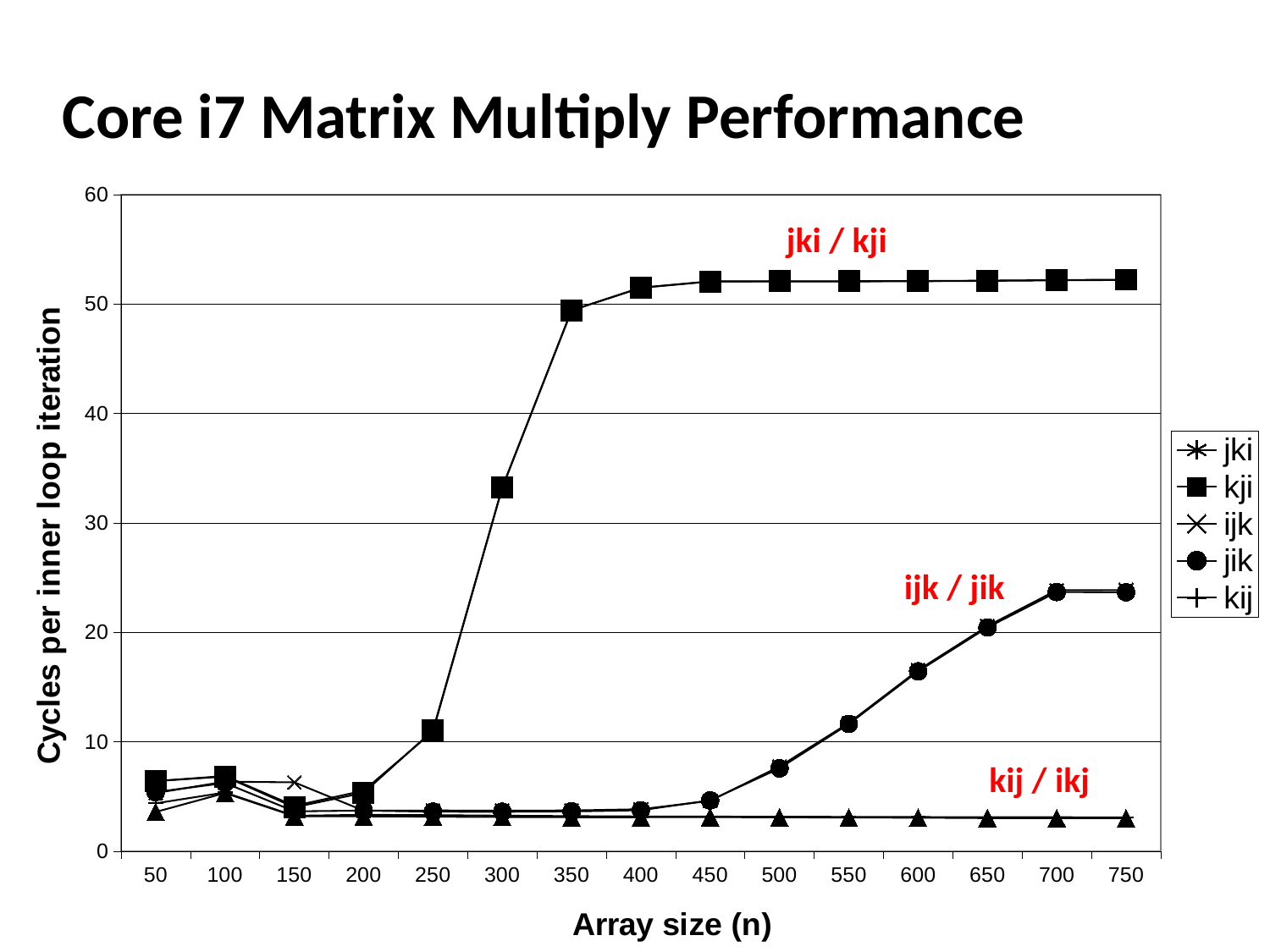
Does the kji series rise or fall between array sizes 200 and 400? rise What kind of chart is shown on the slide? line chart What is the title of the x axis? Array size (n) How many array sizes are plotted along the x axis? 15 Is the value for jik at array size 700 greater or less than 20? greater Is the value for kji at array size 350 greater or less than 40? greater At array size 750, which series has the larger value, kji or jik? kji Is the value for jik at array size 500 greater or less than 10? less How many series does the legend list? 5 What is the title of the y axis? Cycles per inner loop iteration